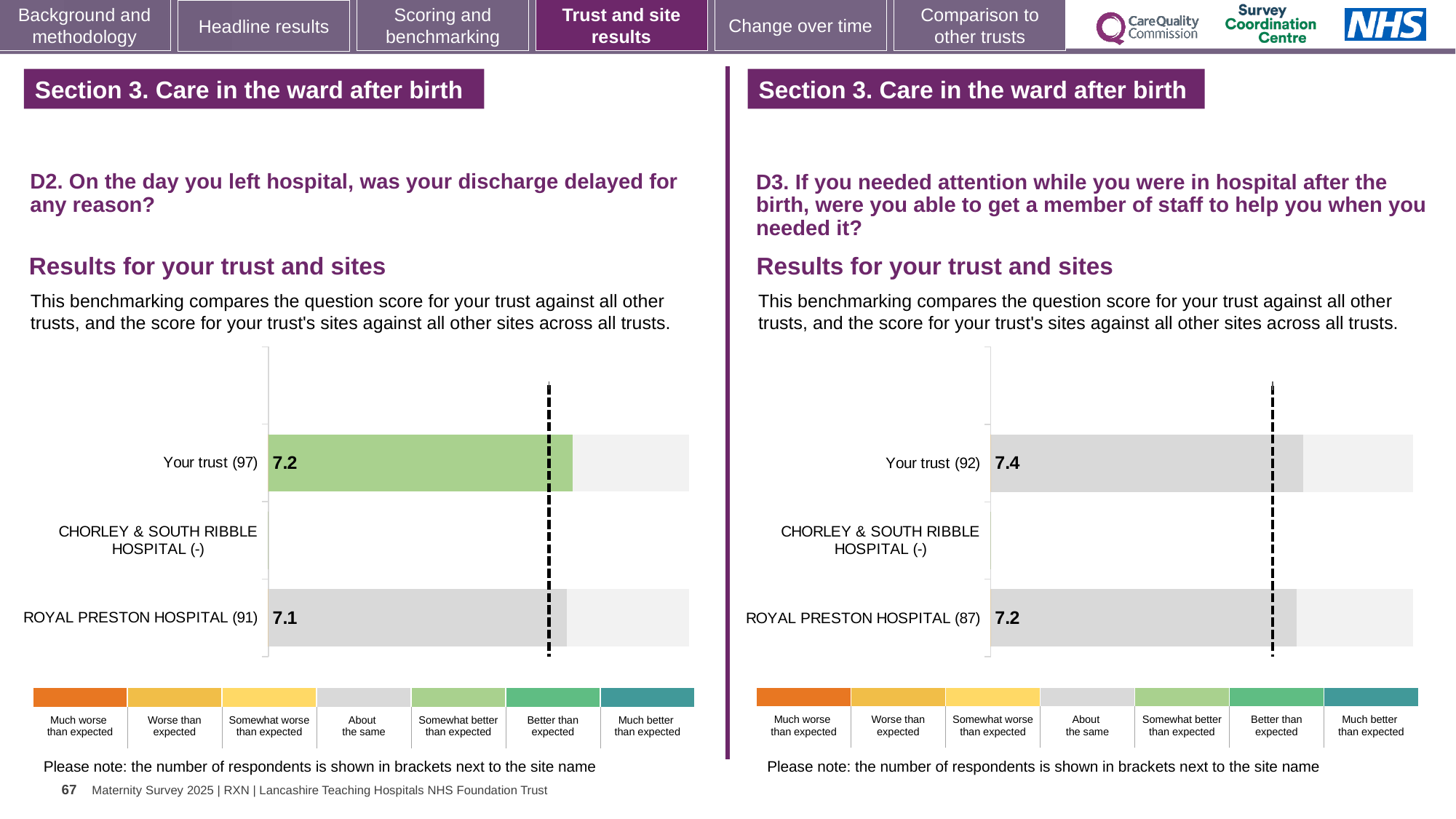
On the right chart (D3), what is the score for Royal Preston Hospital? 7.2 What kind of chart is used on the left (D2) to show the results for your trust and sites? Bar chart On the right chart (D3), how many respondents are shown in brackets for Royal Preston Hospital? 87 On the left chart (D2), which benchmarking category does the colour of the Your trust bar indicate? Somewhat better than expected On the right chart (D3), what is the difference between the score for Your trust and the score for Royal Preston Hospital? 0.2 On the right chart (D3), which benchmarking category does the colour of the Your trust bar indicate? About the same On the left chart (D2), what is the score for Your trust? 7.2 On the right chart (D3), what is the score for Your trust? 7.4 On the left chart (D2), what is the score for Royal Preston Hospital? 7.1 On the right chart (D3), which has the higher score, Your trust or Royal Preston Hospital? Your trust On the left chart (D2), how many respondents are shown in brackets for Your trust? 97 On the left chart (D2), what is the difference between the score for Your trust and the score for Royal Preston Hospital? 0.1